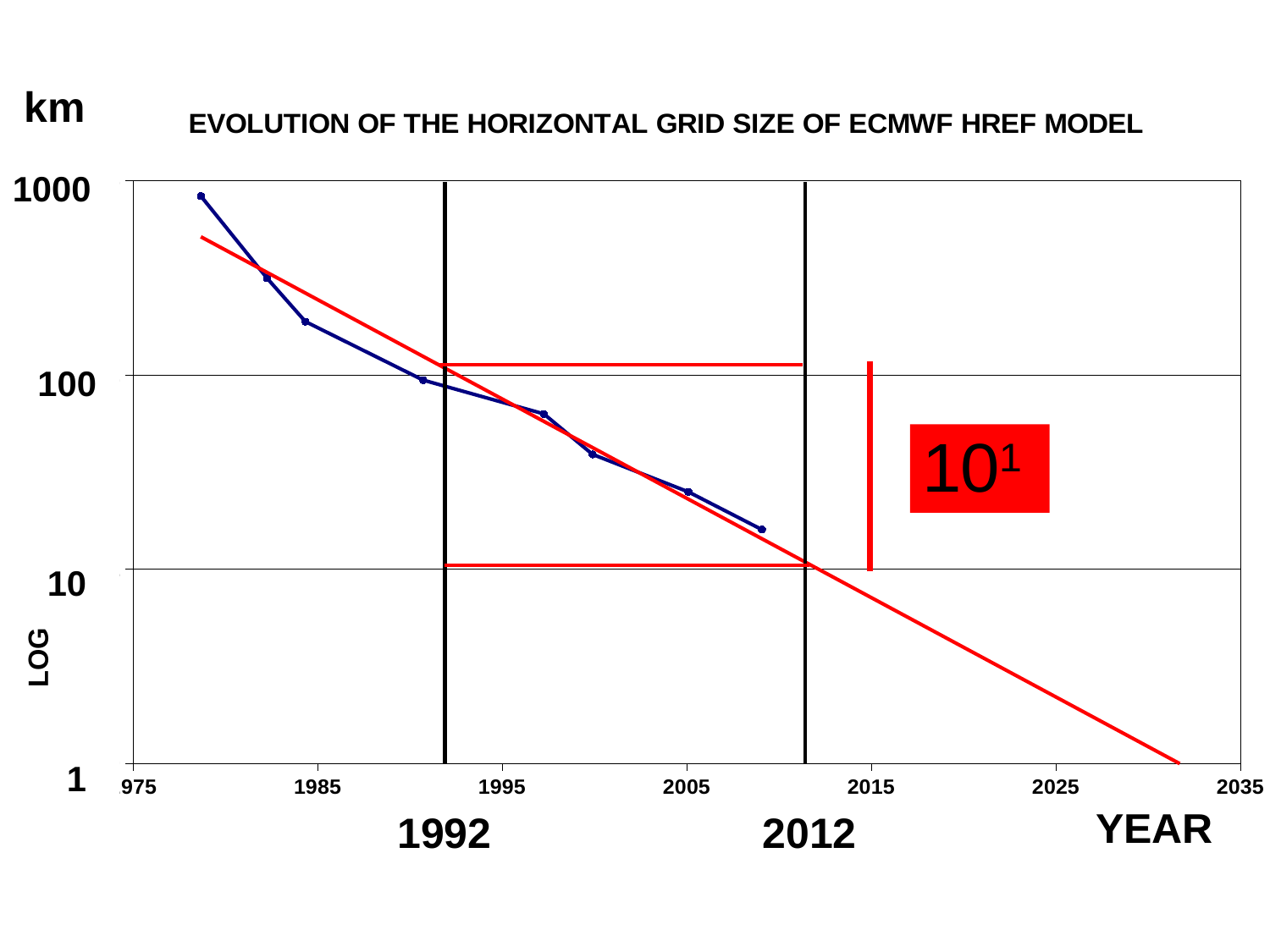
Is the grid size value for the latest plotted point (around 2009) greater or less than 10? greater Is the grid size value for the point plotted around 2005 greater or less than 100? less What kind of chart is shown on the slide? line chart Is the grid size value for the point plotted around 1984 greater or less than 100? greater How many data points are plotted on the blue line? 8 What unit is shown for the y axis of the chart? km What is the title of the chart? EVOLUTION OF THE HORIZONTAL GRID SIZE OF ECMWF HREF MODEL Do the plotted grid size values rise or fall as the year increases along the x axis? fall Which two years are marked by the vertical black lines on the chart? 1992 and 2012 Which plotted point has the highest grid size value, the earliest one or the latest one? the earliest one